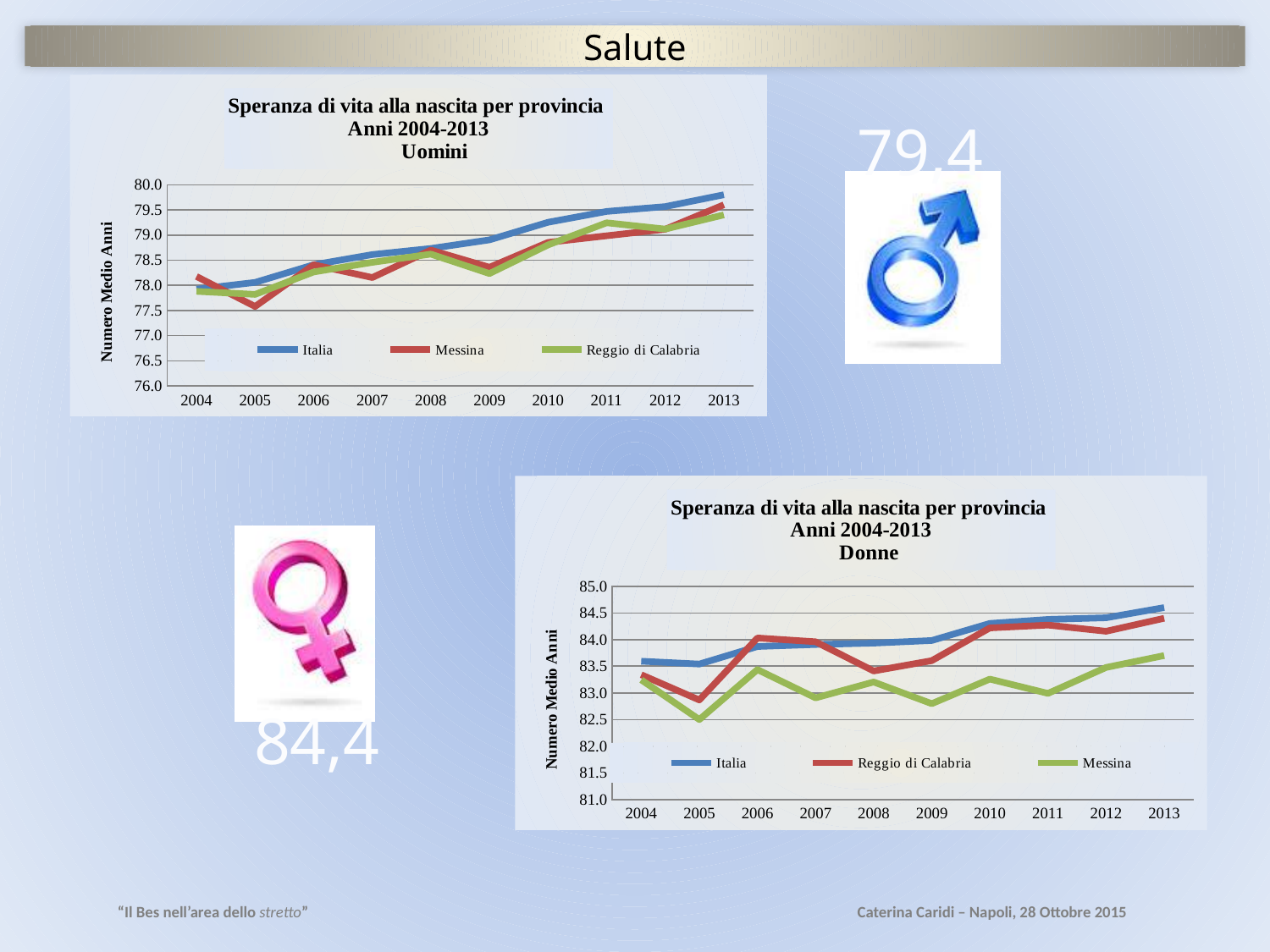
How many series does the legend of the 'Donne' chart list? 3 In the 'Uomini' chart, does the Italia line rise or fall from 2004 to 2013? rise What kind of chart is the 'Uomini' chart at the top left of the slide? line chart In the 'Uomini' chart, is the value for Messina in 2005 greater or less than 78.0? less What is the y-axis label of the 'Donne' chart? Numero Medio Anni In the 'Uomini' chart, which is larger in 2005: Italia or Messina? Italia In the 'Donne' chart, does the Italia line rise or fall from 2004 to 2013? rise In the 'Donne' chart, is the value for Messina in 2009 greater or less than 83.0? less In the 'Uomini' chart, is the value for Italia in 2013 greater or less than 79.5? greater How many years are shown on the x axis of the 'Uomini' chart? 10 In the 'Donne' chart, which is larger in 2013: Italia or Messina? Italia